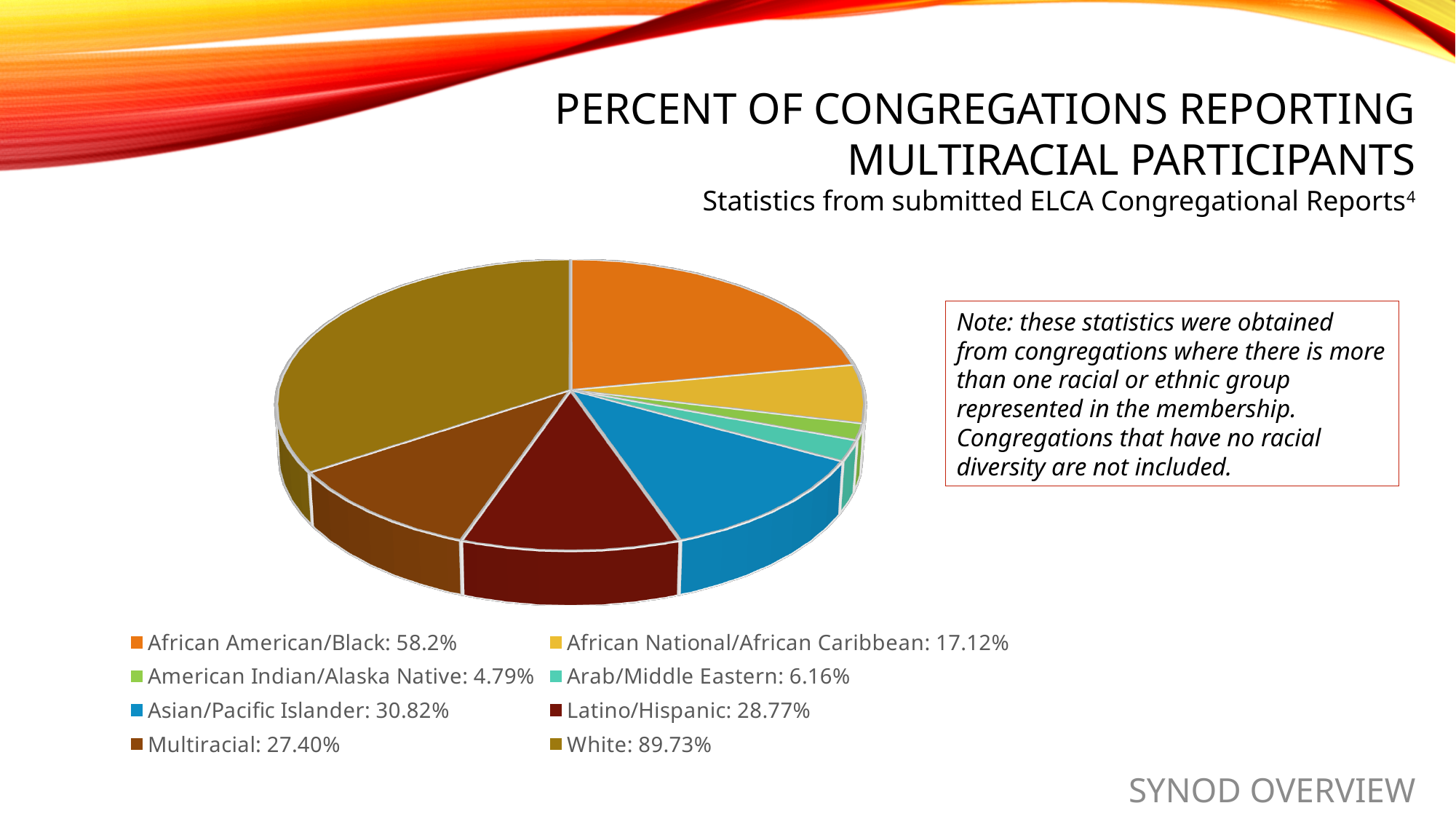
Which category has the lowest value in the pie chart? American Indian/Alaska Native What value is shown for Arab/Middle Eastern? 6.16% What is the difference between the values for White and African American/Black? 31.53% How many categories does the pie chart show? 8 What is the difference between the values for Asian/Pacific Islander and Latino/Hispanic? 2.05% Which is larger, the value for African National/African Caribbean or the value for Arab/Middle Eastern? African National/African Caribbean What colour represents Latino/Hispanic in the pie chart? Dark red Which category has the highest value in the pie chart? White What kind of chart is shown on the slide? Pie chart What value is shown for Multiracial? 27.40% What value is shown for White in the pie chart? 89.73% What value is shown for Asian/Pacific Islander? 30.82%